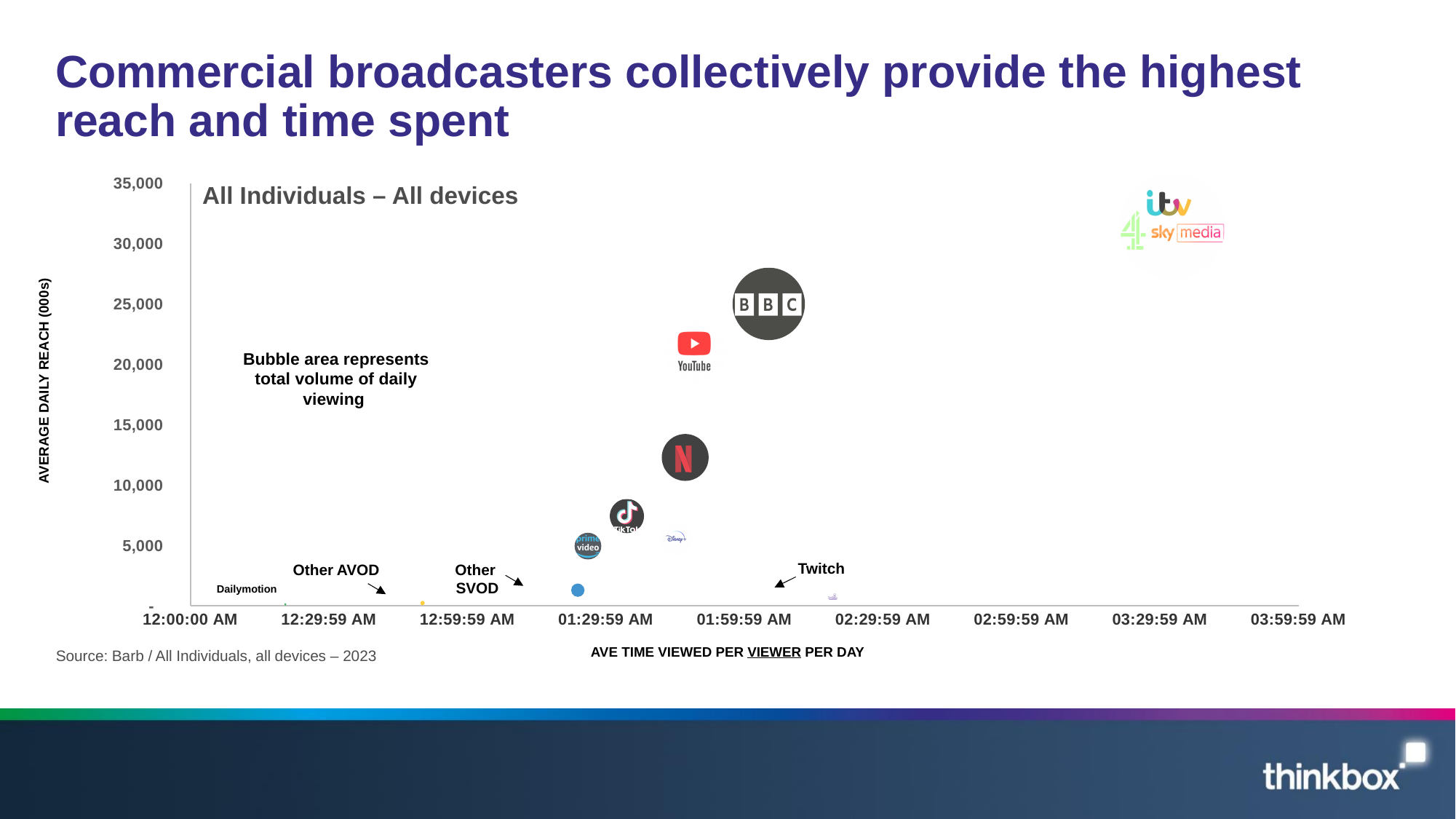
Which bubble has the highest average daily reach? ITV / Channel 4 / Sky Media (commercial broadcasters) Is the average daily reach for YouTube greater or less than 20,000? greater Is the average daily reach for Netflix greater or less than 15,000? less Which has the longer average time viewed per viewer per day, BBC or Netflix? BBC Is the average daily reach for BBC greater or less than 20,000? greater Which has the higher average daily reach, BBC or YouTube? BBC What kind of chart is shown on the slide? Bubble chart According to the chart annotation, what does the bubble area represent? Total volume of daily viewing Which has the higher average daily reach, Netflix or TikTok? Netflix What is the subtitle shown inside the chart area? All Individuals – All devices